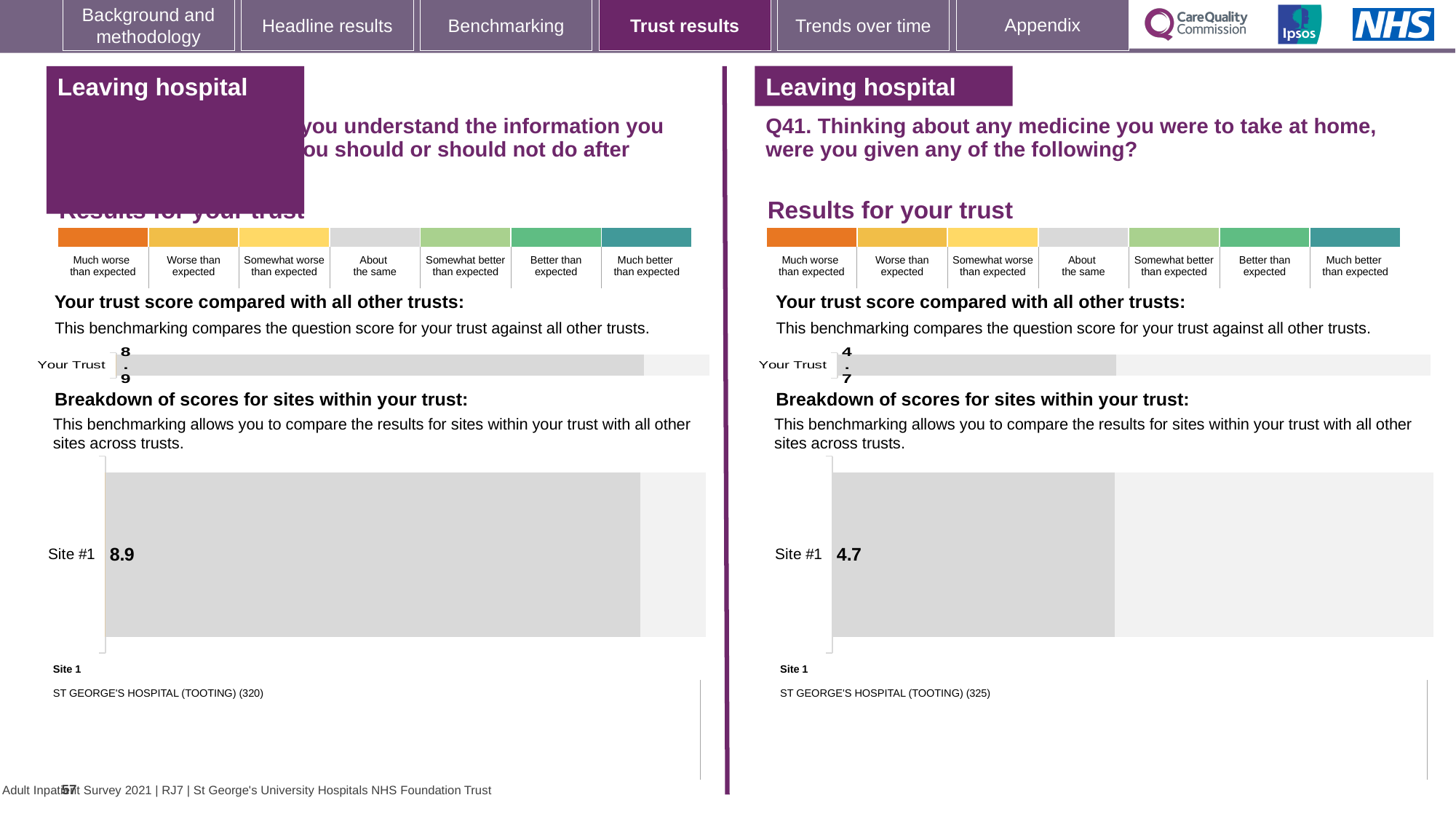
How many sites are shown in the breakdown of scores chart on the left-hand side? 1 On the right-hand chart (Q41), what score is shown for Site #1 in the breakdown of scores for sites within your trust? 4.7 On the right-hand chart (Q41), what is the score shown for Your Trust? 4.7 Which Site #1 score is larger: the one on the left-hand chart or the one on the right-hand chart (Q41)? Left-hand chart Which Your Trust score is larger: the left-hand chart or the right-hand chart (Q41)? Left-hand chart Which hospital is listed as Site 1 beneath the right-hand chart (Q41)? ST GEORGE'S HOSPITAL (TOOTING) What kind of chart is used to show the breakdown of scores for sites within your trust on the right-hand side? Bar chart On the left-hand chart, what score is shown for Site #1 in the breakdown of scores for sites within your trust? 8.9 What is the difference between the Site #1 score on the left-hand chart and the Site #1 score on the right-hand chart (Q41)? 4.2 On the left-hand chart, what is the score shown for Your Trust? 8.9 On the right-hand chart (Q41), what is the difference between the Your Trust score and the Site #1 score? 0 What number of respondents is shown in brackets for Site 1 beneath the right-hand chart (Q41)? 325